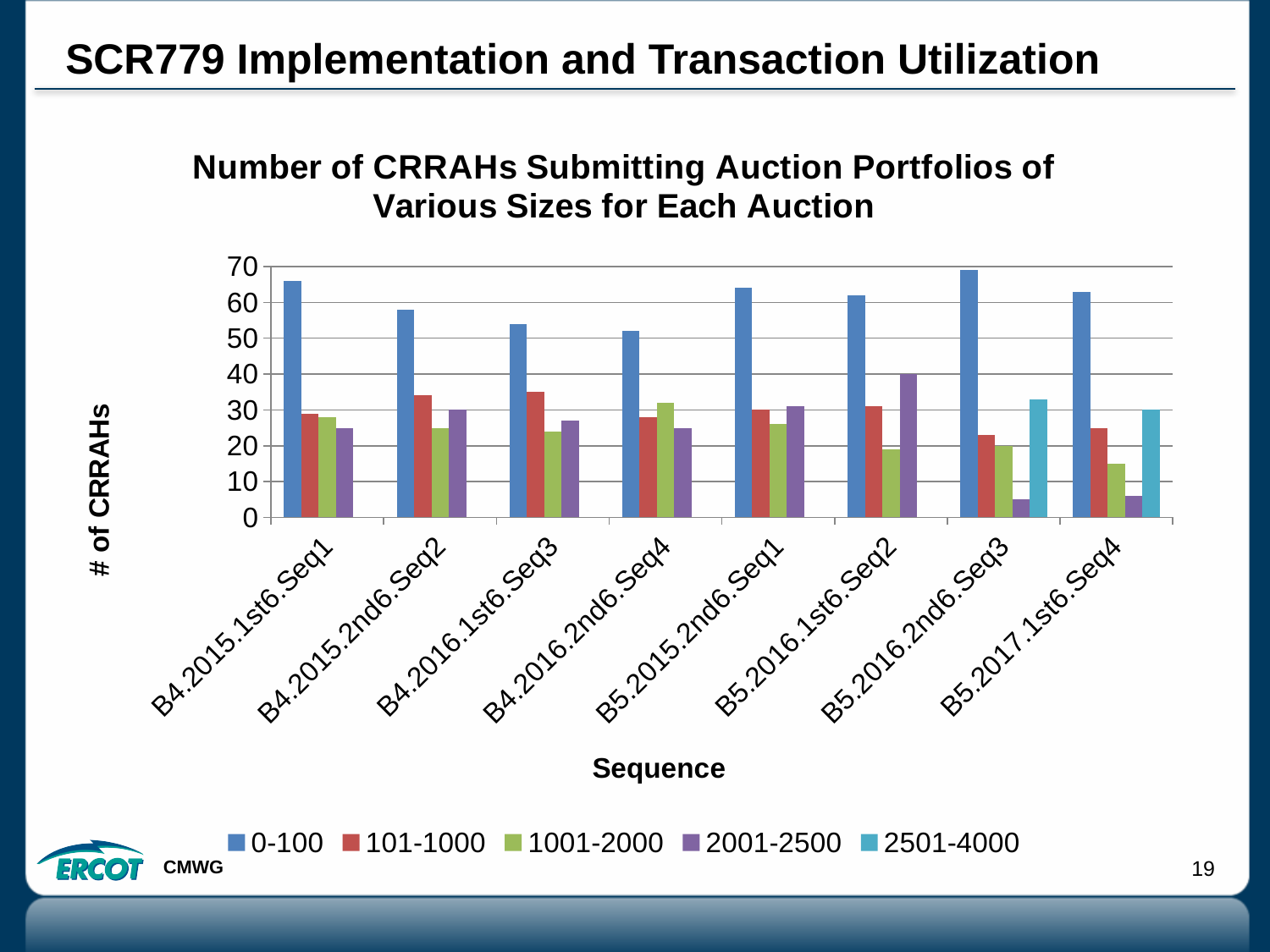
How many sequences (categories) are shown on the x axis? 8 Is the 0-100 value for B4.2015.1st6.Seq1 greater or less than 60? greater What is the title of the y axis? # of CRRAHs For B4.2016.2nd6.Seq4, which is larger: the 1001-2000 value or the 101-1000 value? 1001-2000 Is the 2001-2500 value for B5.2016.2nd6.Seq3 greater or less than 10? less Which sequence has the highest value for the 0-100 series? B5.2016.2nd6.Seq3 For B5.2017.1st6.Seq4, which series has the lowest value? 2001-2500 Is the 2001-2500 value for B5.2016.1st6.Seq2 greater or less than 30? greater For B5.2016.1st6.Seq2, which is larger: the 2001-2500 value or the 1001-2000 value? 2001-2500 What kind of chart is shown on the slide? bar chart How many series does the legend list? 5